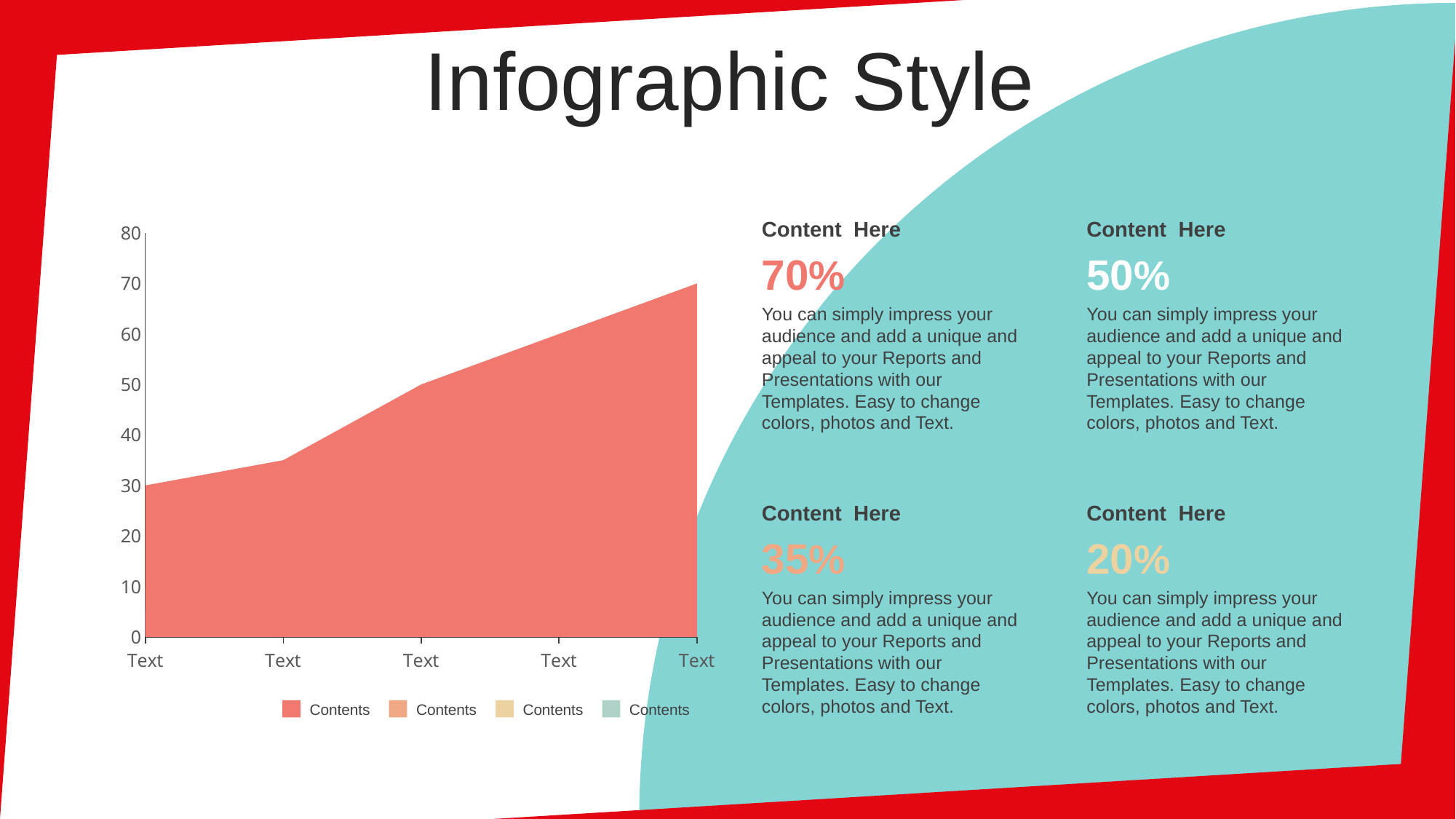
What is the value of the middle (third) point in the chart? 50 Which point in the chart has the highest value, the leftmost or the rightmost? rightmost Which point in the chart has the lowest value? the leftmost point What is the value of the leftmost point in the chart? 30 What is the difference between the rightmost point's value and the leftmost point's value in the chart? 40 Do the values in the chart rise or fall from left to right along the x axis? rise What kind of chart is shown on the slide? area chart Is the value of the second point from the left greater or less than 40? less What is the highest value shown on the chart's vertical axis? 80 What is the value of the rightmost point in the chart? 70 How many data points are plotted along the x axis of the chart? 5 How many entries does the chart's legend list? 4